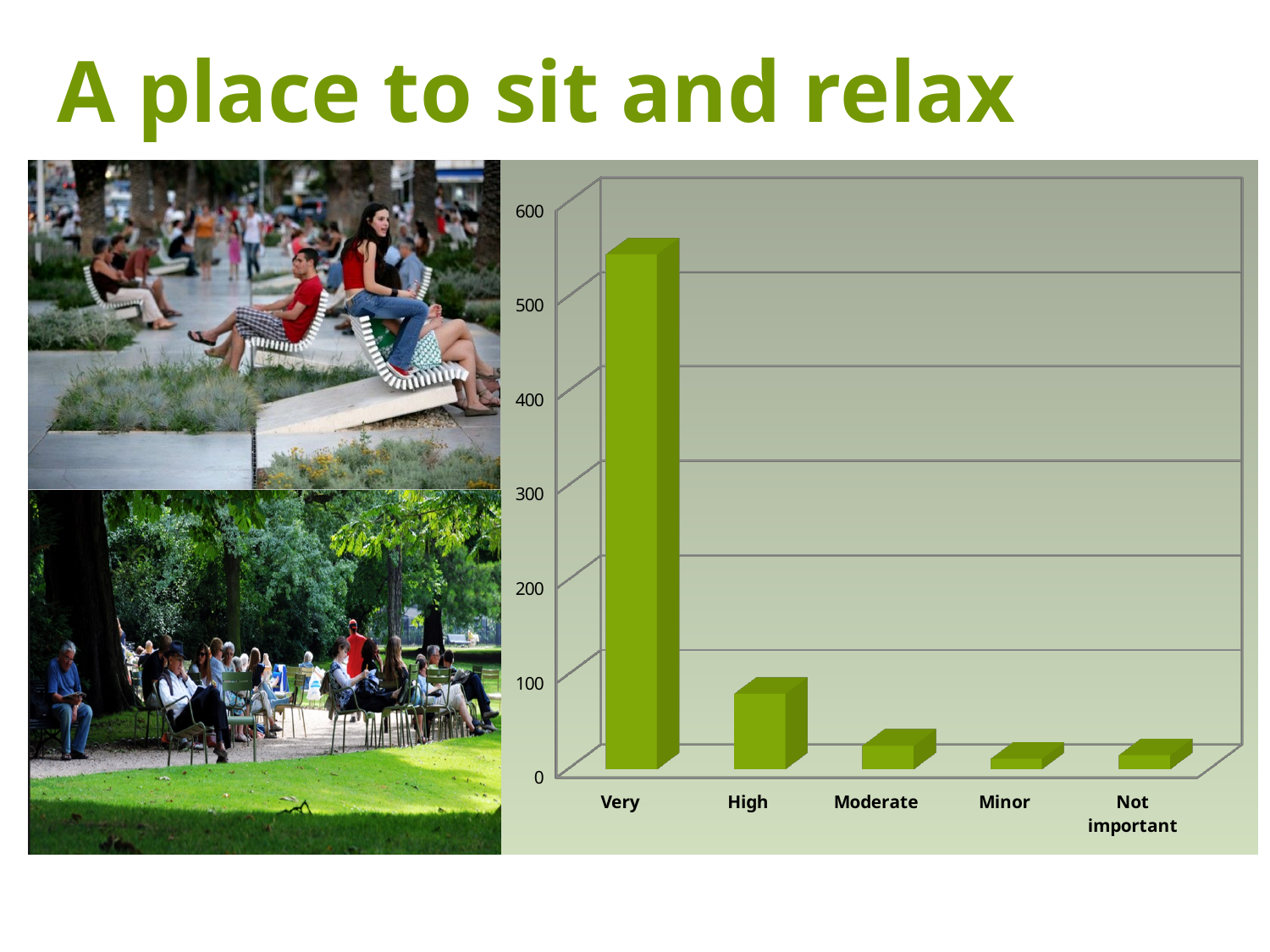
Is the value for High greater or less than 100? less Which is larger, the value for High or the value for Moderate? High Which is larger, the value for Very or the value for High? Very What is the label of the last category on the x axis of the chart? Not important Is the value for Moderate greater or less than 100? less Do the values rise or fall from Very to Moderate along the x axis? fall Is the value for Very greater or less than 500? greater What is the highest value shown on the chart's vertical axis? 600 What kind of chart is shown on the slide? bar chart Which category has the highest value in the chart? Very How many categories are shown on the x axis of the chart? 5